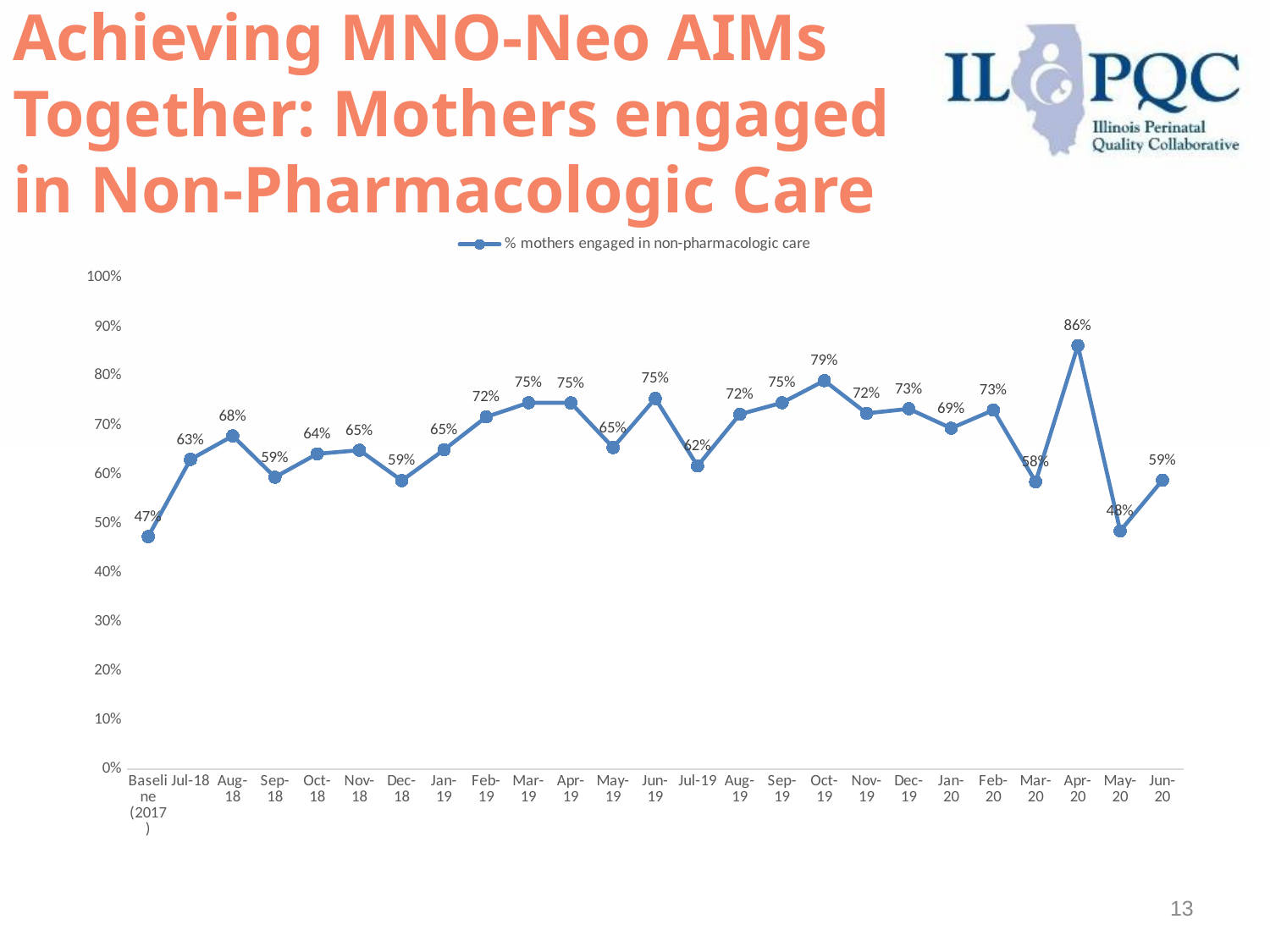
What is the difference between the values for Oct-19 and Baseline (2017)? 32 percentage points How many data points are plotted on the chart? 25 What is the value for Jun-20? 59% How many series does the legend list? 1 Which is larger, the value for Jun-19 or the value for Jul-19? Jun-19 What kind of chart is shown on the slide? line chart What is the value for Baseline (2017)? 47% Is the value for Mar-20 greater or less than 60%? less Which month has the highest percentage of mothers engaged in non-pharmacologic care? Apr-20 What is the difference between the values for Apr-20 and May-20? 38 percentage points What is the value for Oct-19? 79% Does the value rise or fall from Apr-20 to May-20? fall